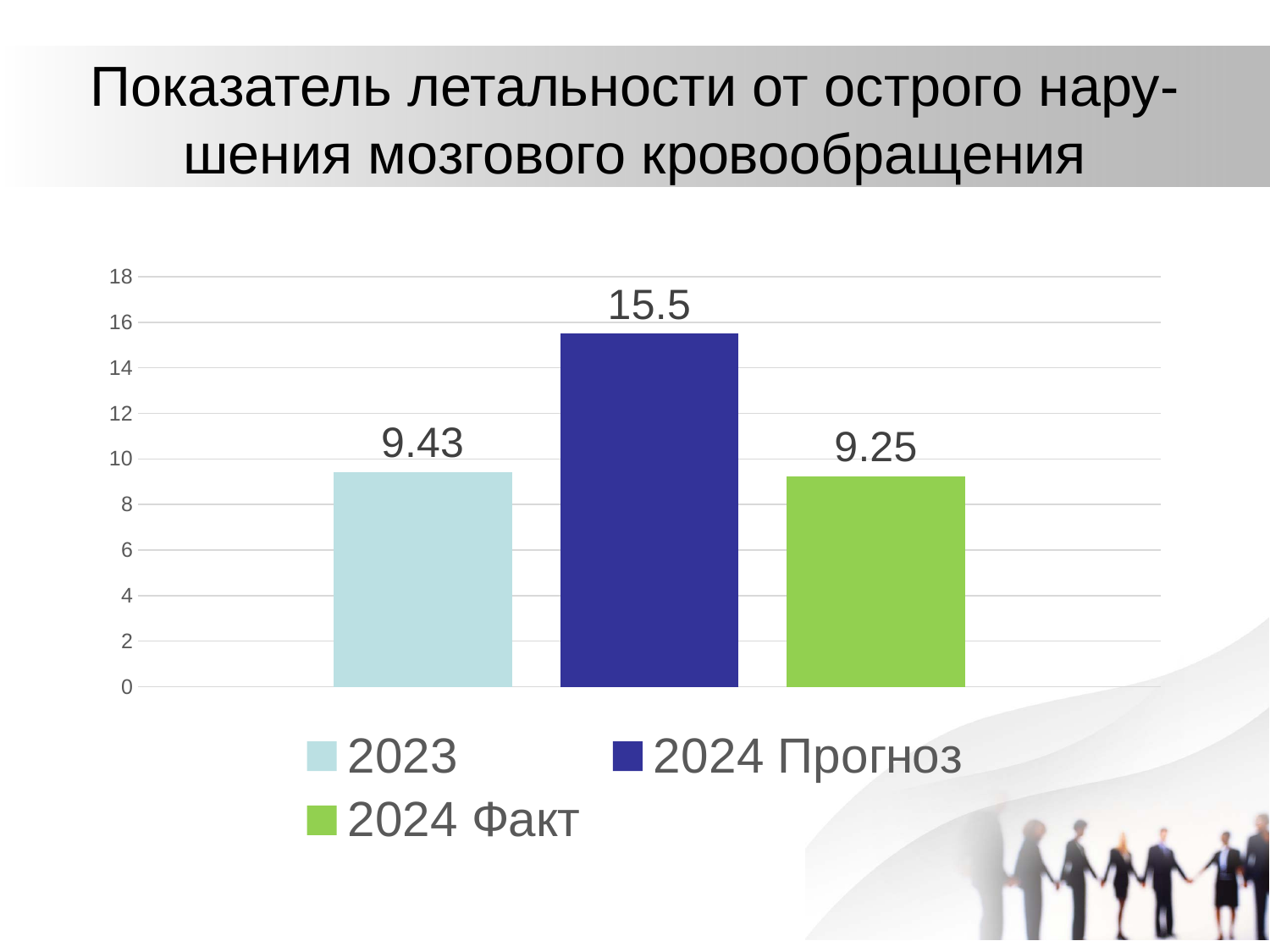
What is the difference between the 2024 Прогноз value and the 2024 Факт value? 6.25 How many series does the legend list? 3 What is the value for 2024 Прогноз? 15.5 Which is larger, the value for 2023 or the value for 2024 Прогноз? 2024 Прогноз What is the value for 2023? 9.43 Is the value for 2024 Прогноз greater or less than 14? greater What is the value for 2024 Факт? 9.25 What colour is the bar for 2024 Факт? green Which series has the lowest value? 2024 Факт What kind of chart is shown on the slide? bar chart What is the difference between the 2023 value and the 2024 Факт value? 0.18 Which series has the highest value? 2024 Прогноз